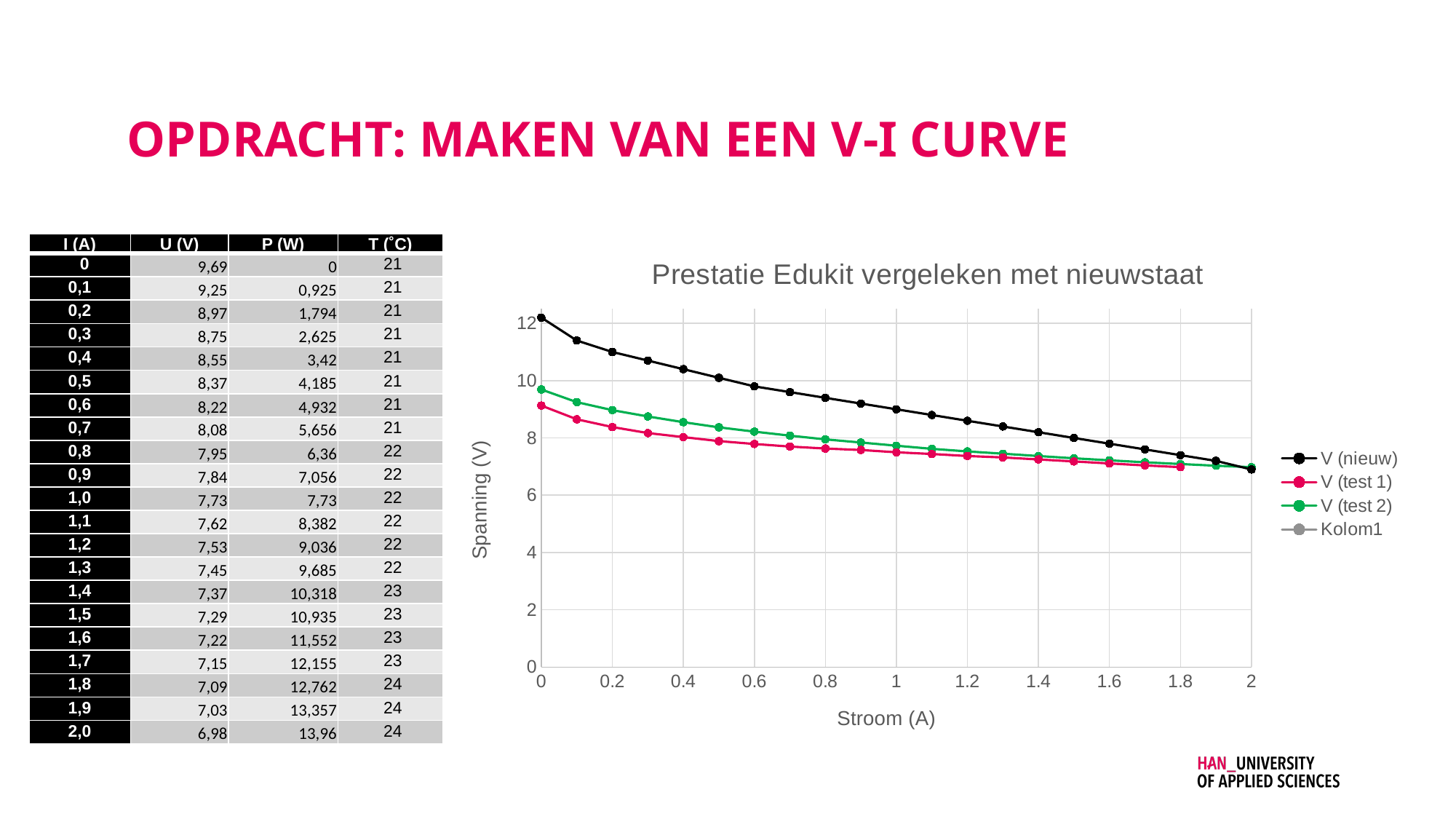
What kind of chart is shown on the slide? Line chart Do the voltage values rise or fall as the current increases along the x axis? Fall Which series has the lowest voltage at 0 A? V (test 1) What is the title of the chart? Prestatie Edukit vergeleken met nieuwstaat Is the value for V (test 1) at 0 A greater or less than 10? less What is the label of the x axis of the chart? Stroom (A) At 0.2 A, which is larger: V (nieuw) or V (test 1)? V (nieuw) Which series has the highest voltage at 0 A? V (nieuw) How many series does the chart's legend list? 4 Is the value for V (nieuw) at 2 A greater or less than 8? less Is the value for V (nieuw) at 0.4 A greater or less than 10? greater How many data points does the V (nieuw) series have? 21